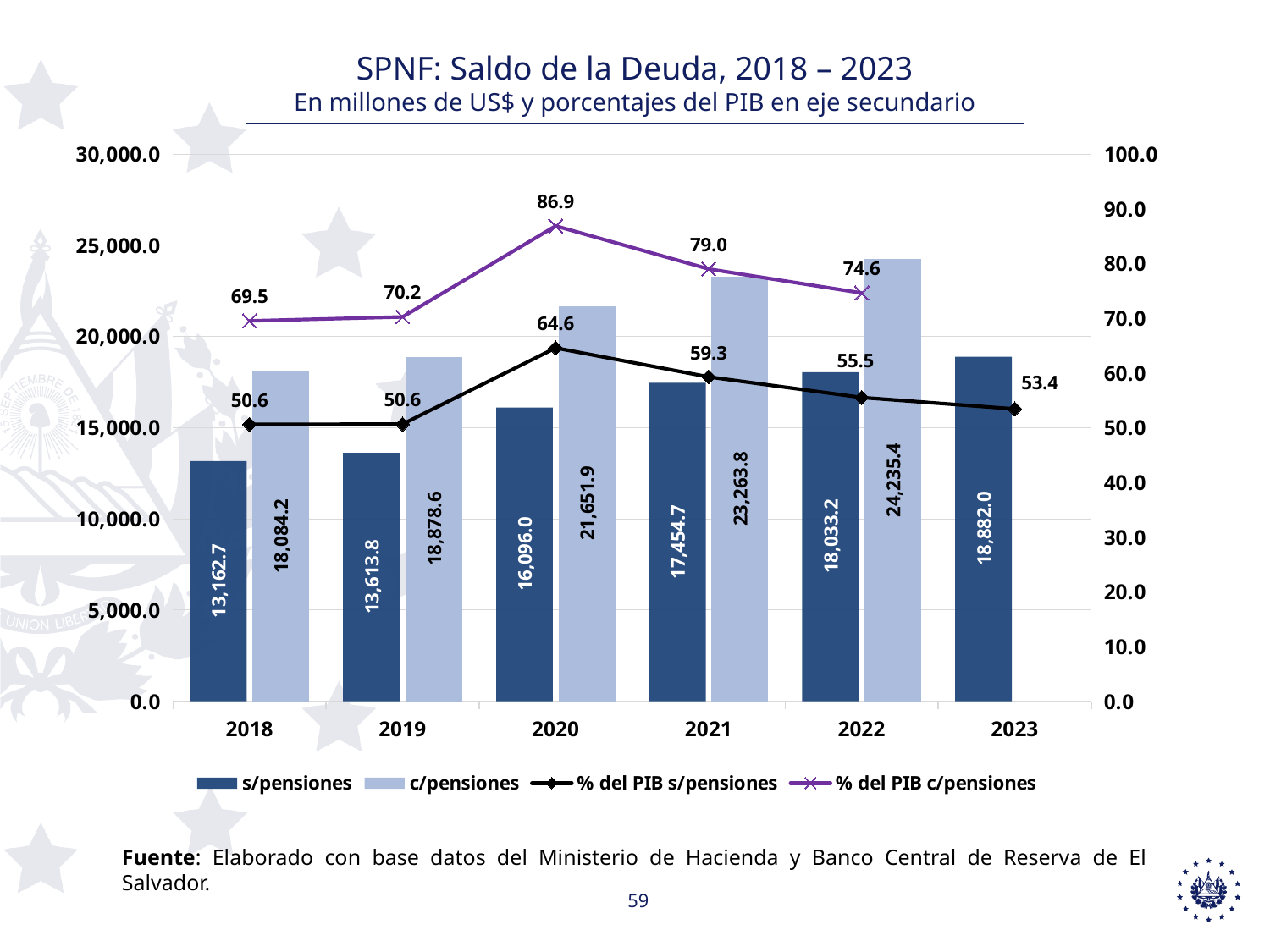
What is the % del PIB s/pensiones value for 2023? 53.4 What is the value of the c/pensiones bar for 2022? 24,235.4 What is the difference between the % del PIB c/pensiones and % del PIB s/pensiones values in 2020? 22.3 What is the % del PIB c/pensiones value for 2020? 86.9 Which is larger, the s/pensiones bar for 2022 or for 2023? 2023 In which year is the % del PIB s/pensiones line at its highest? 2020 What is the value of the s/pensiones bar for 2020? 16,096.0 Which year has the lowest s/pensiones bar? 2018 What is the difference between the c/pensiones and s/pensiones bars in 2021? 5,809.1 How many series does the legend list? 4 Does the % del PIB c/pensiones line rise or fall from 2020 to 2022? fall How many years are shown on the x axis? 6